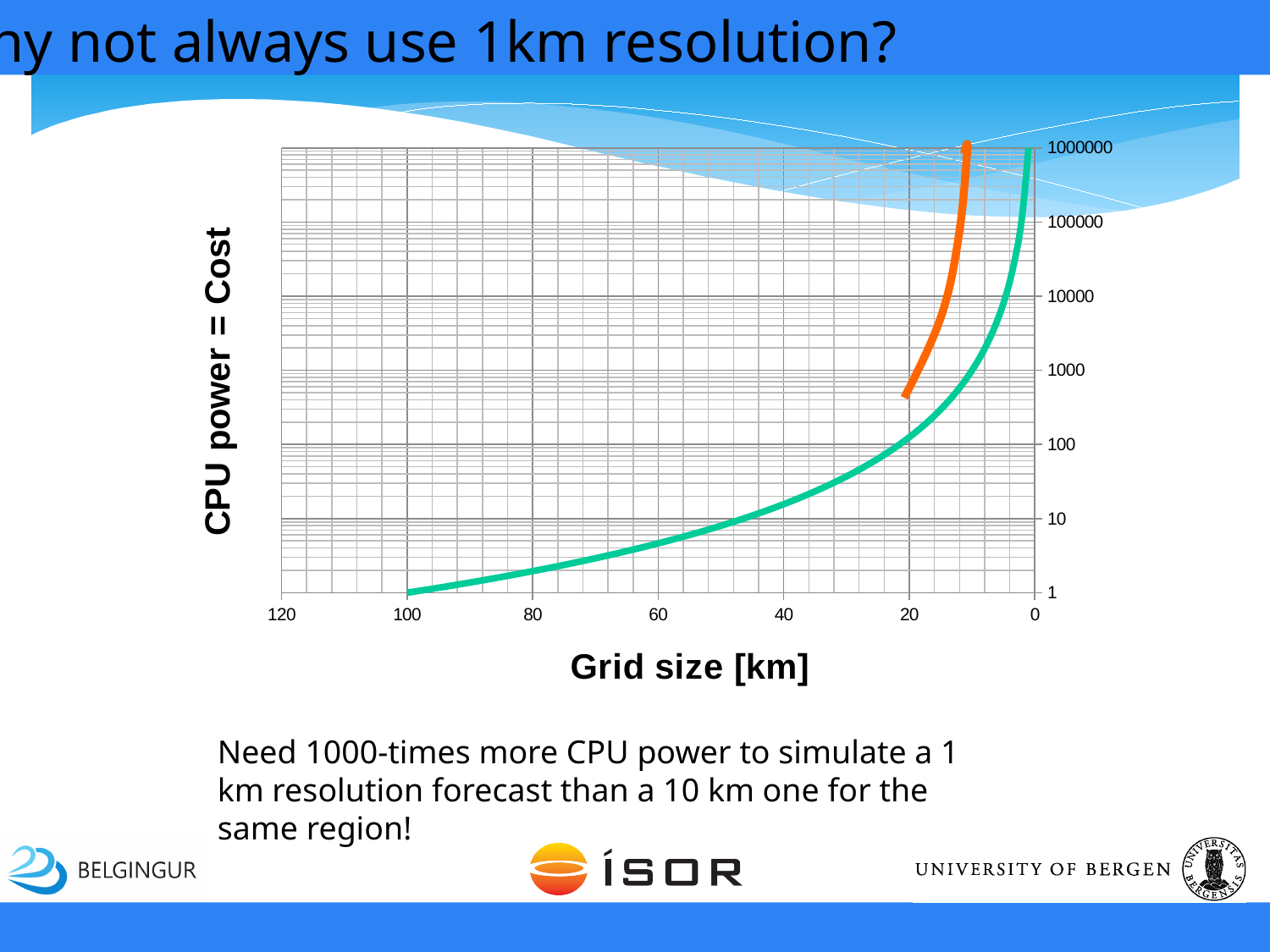
How many tick labels are shown on the x axis? 7 What is the lowest value shown on the y axis? 1 What kind of chart is shown on the slide? line chart Is the value of the green curve at a grid size of 60 km greater or less than 10? less What is the highest value shown on the y axis? 1000000 What is the label of the y axis? CPU power = Cost Is the value of the green curve at a grid size of 80 km greater or less than 10? less What is the label of the x axis? Grid size [km] Moving from left to right along the x axis (from 120 km toward 0 km), do the curve values rise or fall? rise How many curves (series) are plotted on the chart? 2 What is the value of the green curve at a grid size of 100 km? 1 Is the starting value of the orange curve (at about 20 km) greater or less than 100? greater